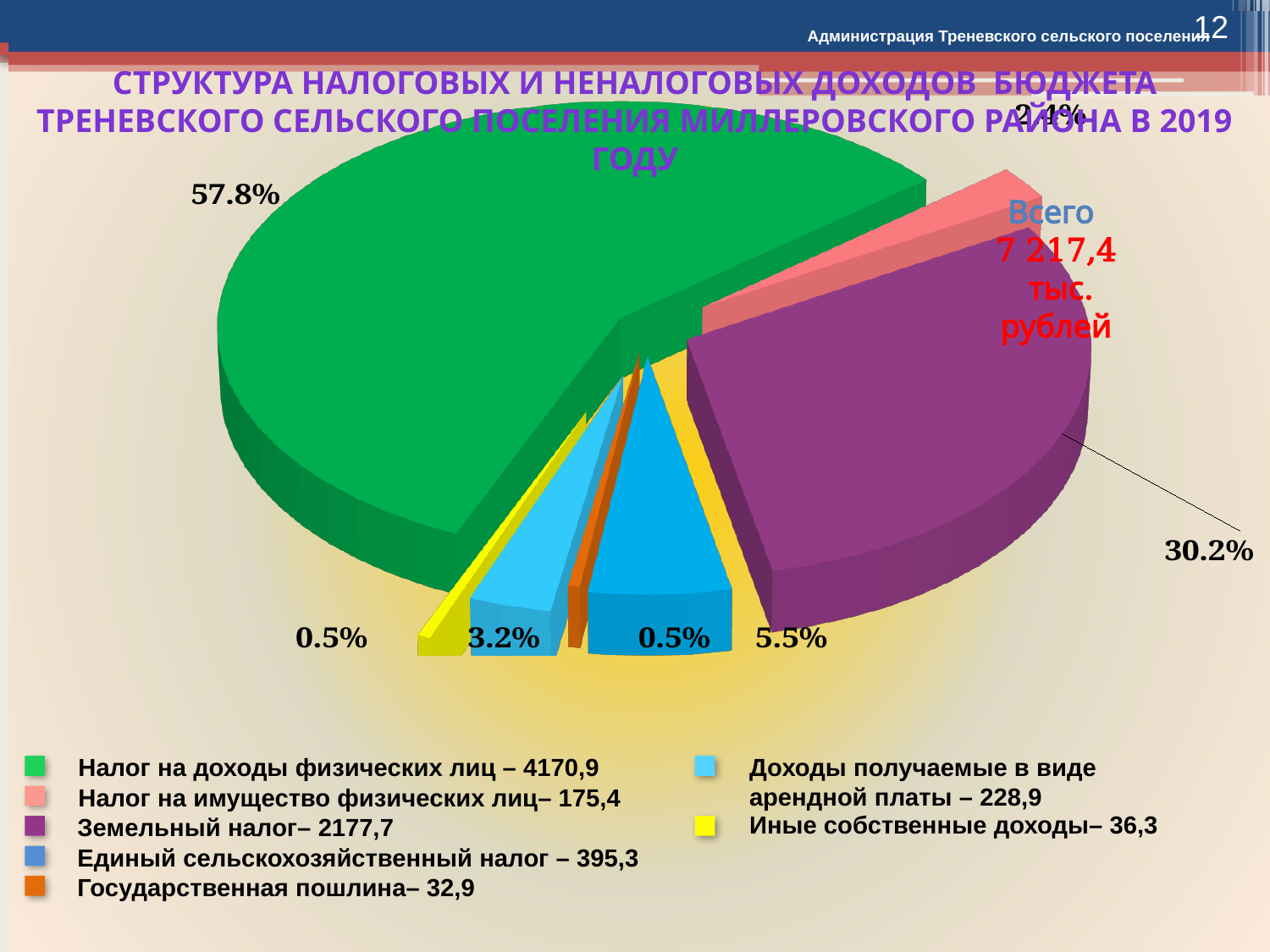
What share of the pie does Налог на доходы физических лиц have? 57.8% What share of the pie does Единый сельскохозяйственный налог have? 5.5% What is the value shown in the legend for Государственная пошлина? 32,9 What share of the pie does Доходы получаемые в виде арендной платы have? 3.2% What is the difference in percentage points between the shares of Налог на доходы физических лиц and Земельный налог? 27.6% What total amount (Всего) is shown on the slide? 7 217,4 тыс. рублей How many slices does the pie chart have? 7 What kind of chart is shown on the slide? pie chart What is the value shown in the legend for Земельный налог? 2177,7 Which is larger, the share of Единый сельскохозяйственный налог or the share of Доходы получаемые в виде арендной платы? Единый сельскохозяйственный налог Which category has the largest share of the pie? Налог на доходы физических лиц